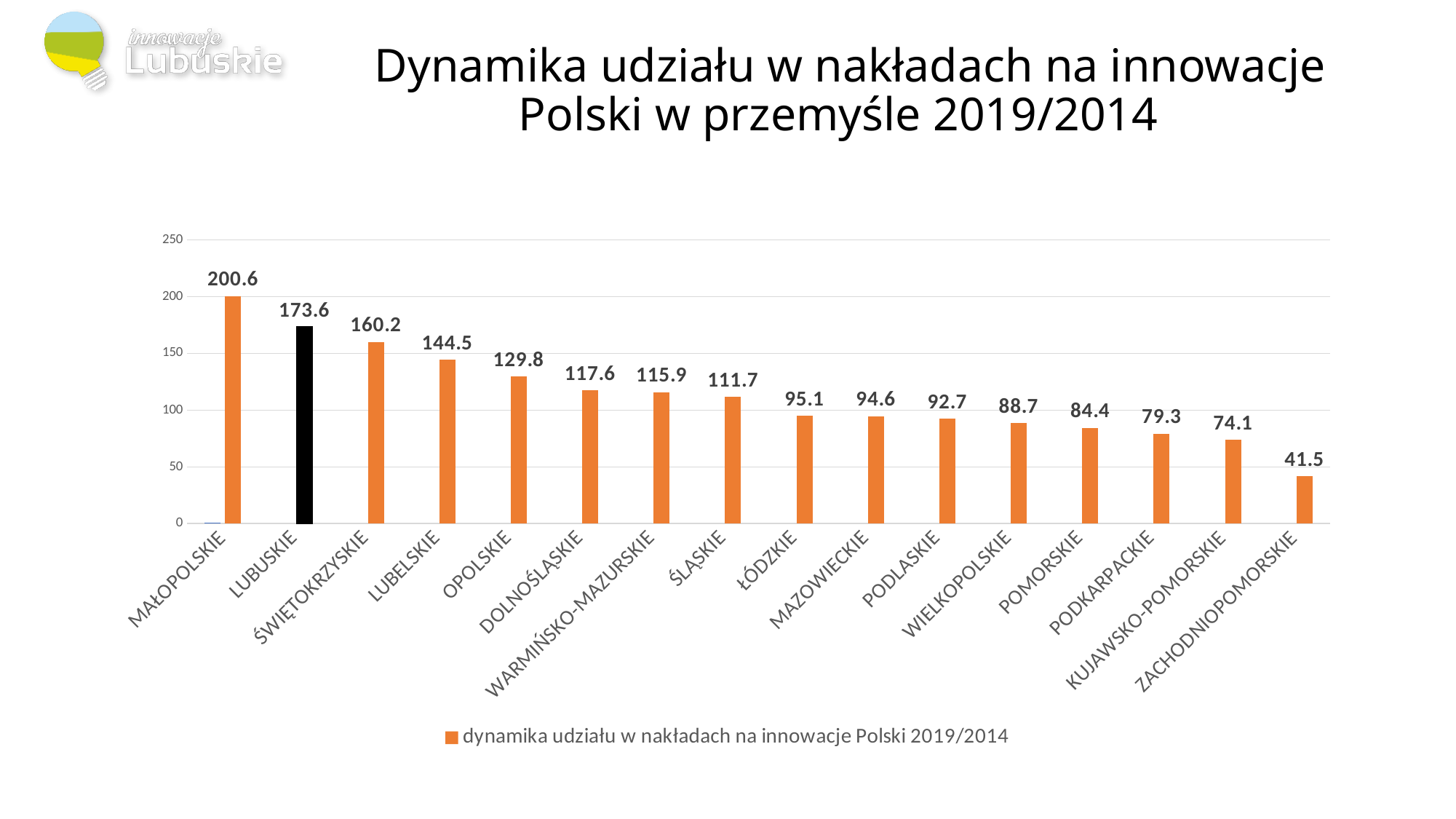
What is the value for PODKARPACKIE? 79.3 What is the value for LUBUSKIE? 173.6 Which region has the highest value? MAŁOPOLSKIE Which bar is coloured black instead of orange? LUBUSKIE Which region has the lowest value? ZACHODNIOPOMORSKIE What is the difference between the values for OPOLSKIE and POMORSKIE? 45.4 Which is larger, the value for LUBELSKIE or the value for DOLNOŚLĄSKIE? LUBELSKIE What kind of chart is shown on the slide? bar chart What is the value for ŚLĄSKIE? 111.7 What is the difference between the values for MAŁOPOLSKIE and LUBUSKIE? 27.0 Is the value for WIELKOPOLSKIE greater or less than 100? less How many regions are shown on the x axis? 16